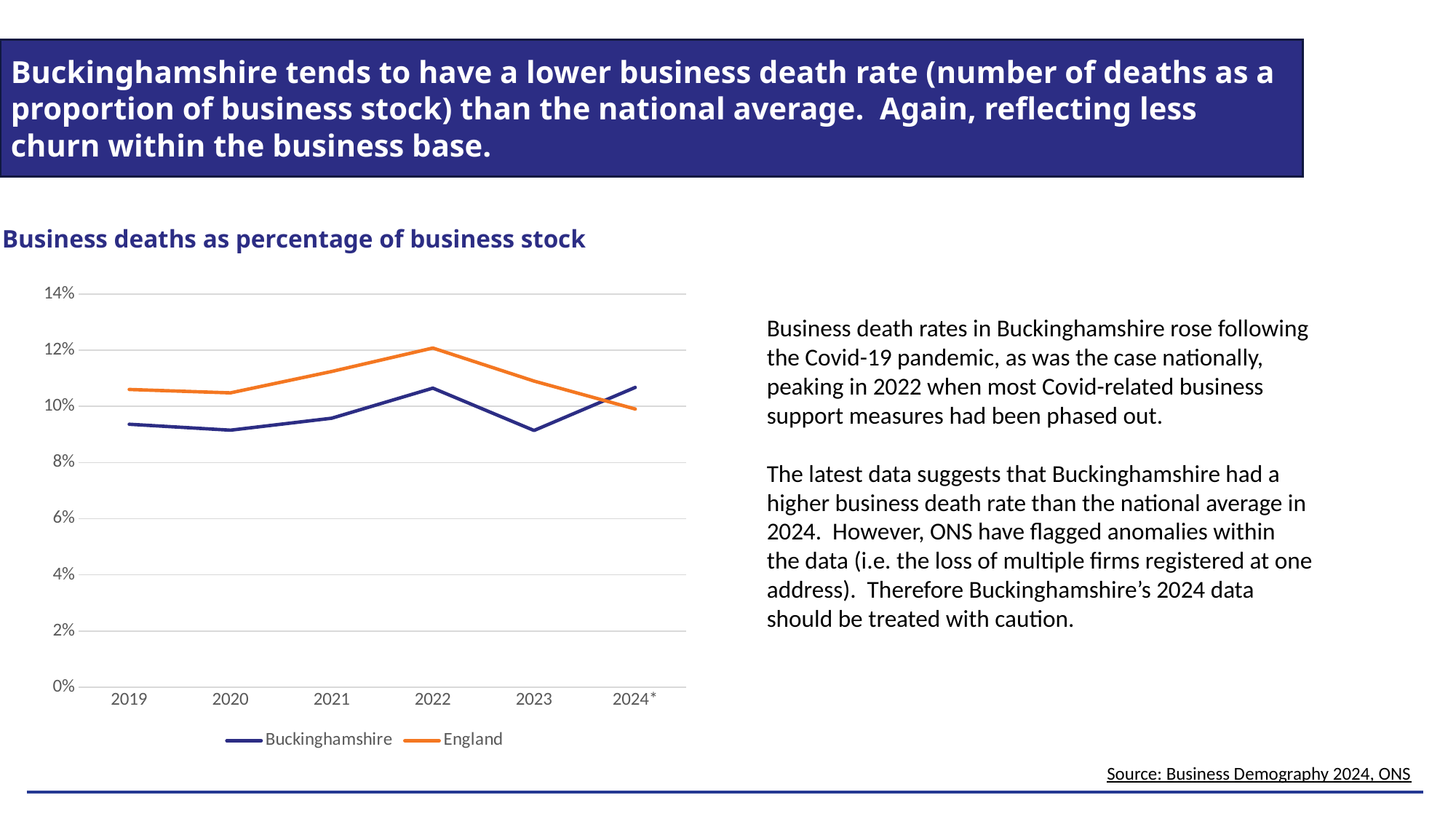
How many years are shown on the x axis of the chart? 6 In 2024*, which series has the higher business death rate, Buckinghamshire or England? Buckinghamshire How many series does the chart legend list? 2 Does the England line rise or fall between 2022 and 2024*? fall Is the value for England in 2022 greater or less than 10%? greater In which year does the England line reach its lowest value? 2024* What kind of chart is shown on the slide? line chart In which year does the England line reach its highest value? 2022 In 2019, which series has the higher business death rate, Buckinghamshire or England? England Is the value for Buckinghamshire in 2022 greater or less than 10%? greater What is the title of the chart? Business deaths as percentage of business stock Is the value for Buckinghamshire in 2023 greater or less than 10%? less